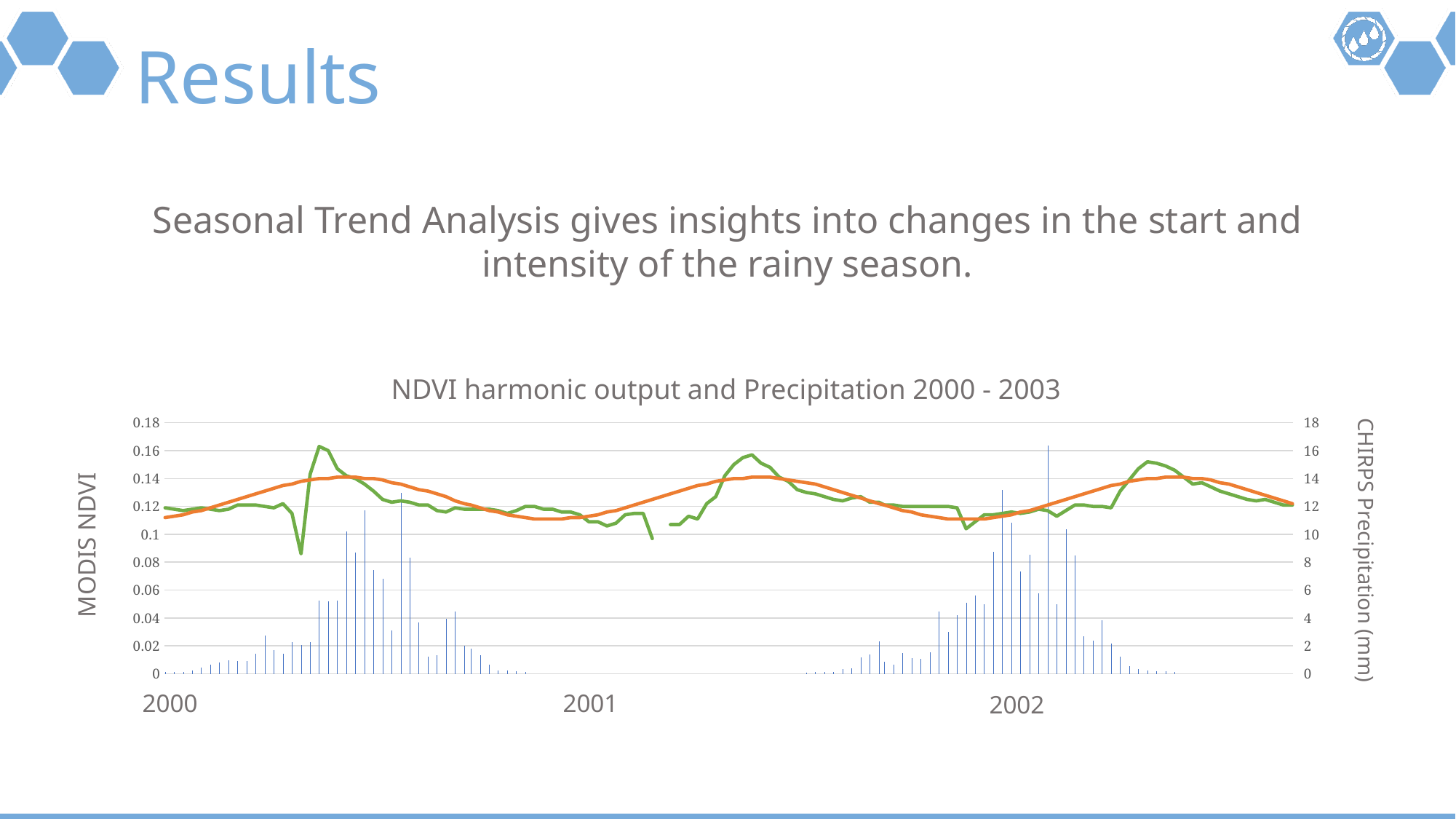
What is the highest tick value on the right (CHIRPS Precipitation) axis? 18 What kind of chart is shown on the slide? Combined line and bar chart What is the title of the chart? NDVI harmonic output and Precipitation 2000 - 2003 Which year label appears first on the x axis? 2000 How many year labels are shown on the x axis? 3 What is the title of the left vertical axis? MODIS NDVI Is the tallest precipitation bar in 2000 greater or less than 10 mm? greater Is the lowest point of the green NDVI line in 2000 greater or less than 0.1? less Is the lowest point of the orange harmonic line greater or less than 0.1? greater Which year has the tallest precipitation bar: 2000 or 2002? 2002 What is the highest tick value on the left (MODIS NDVI) axis? 0.18